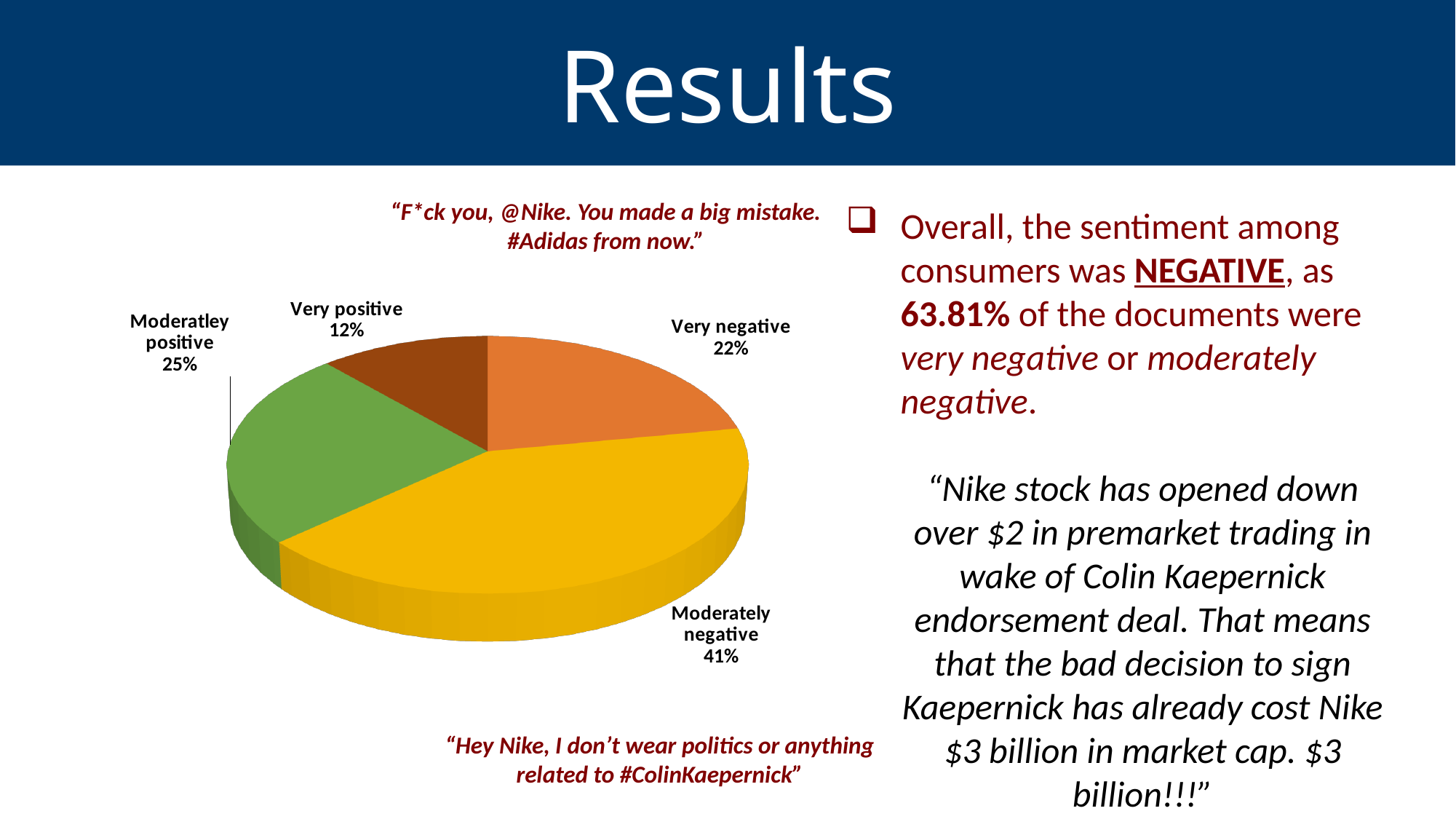
What percentage of documents were Moderately positive? 25% Which is larger, the share for Moderately positive or the share for Very negative? Moderately positive How many categories are shown in the pie chart? 4 What percentage of documents were Very negative? 22% What is the combined share of Very negative and Moderately negative? 63% What percentage of documents were Very positive? 12% What percentage of documents were Moderately negative? 41% Which sentiment category has the largest share of the pie? Moderately negative Which sentiment category has the smallest share of the pie? Very positive What is the difference in percentage points between Moderately negative and Very negative? 19 What kind of chart is shown on the slide? Pie chart What colour is the Moderately negative slice of the pie? Yellow